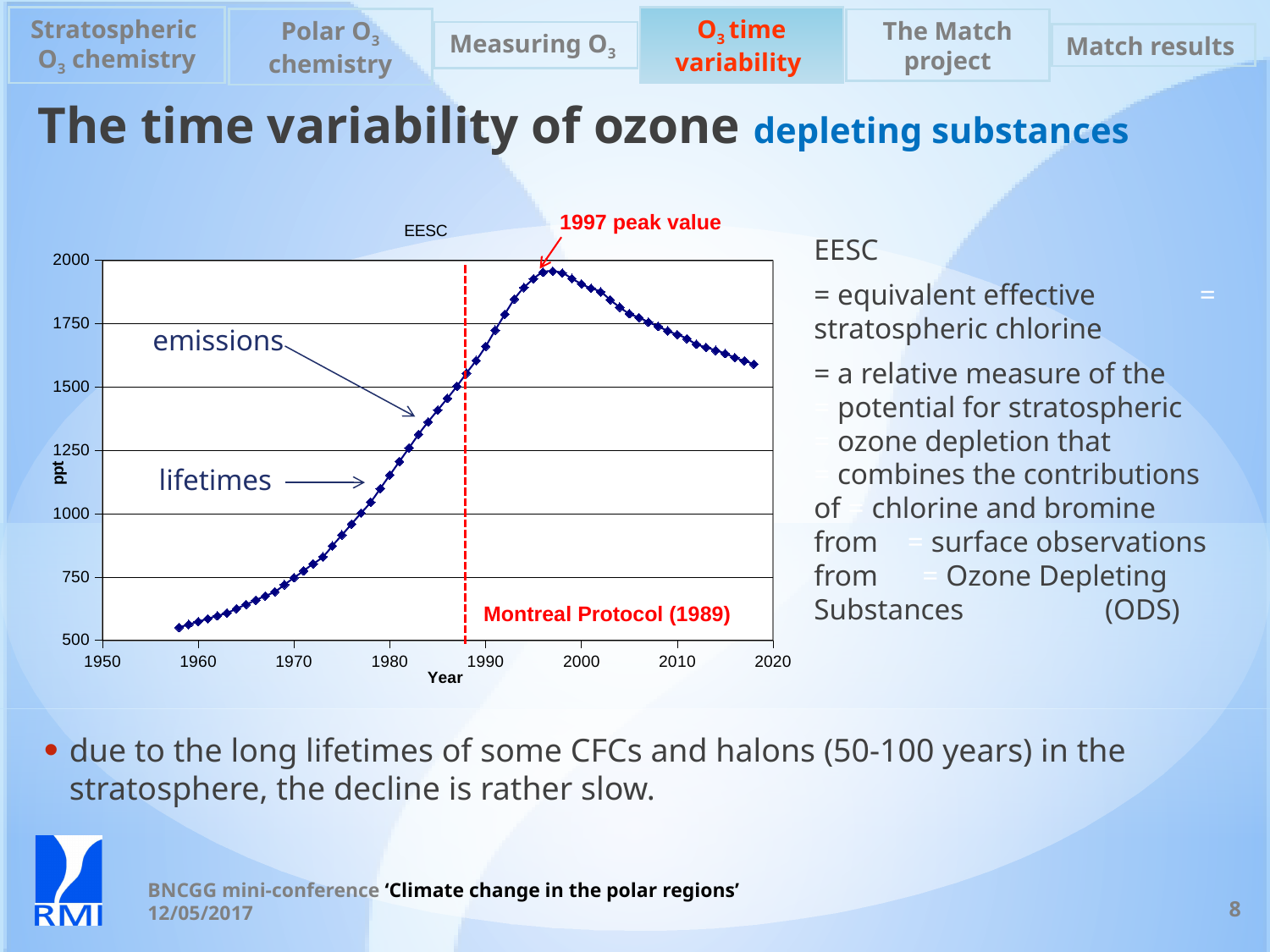
Does the EESC curve rise or fall between 1960 and 1990? rise Which year is marked by the red dashed vertical line labelled Montreal Protocol? 1989 Does the EESC curve rise or fall after 1997? fall Is the EESC value in 1965 greater or less than 1000 ppt? less Is the EESC value in 1960 greater or less than 750 ppt? less What unit is shown on the y-axis of the chart? ppt In which year does the EESC curve reach its peak value? 1997 Is the EESC value at the 1997 peak greater or less than 1750 ppt? greater What kind of chart is shown on the slide? line chart What is the title of the chart? EESC